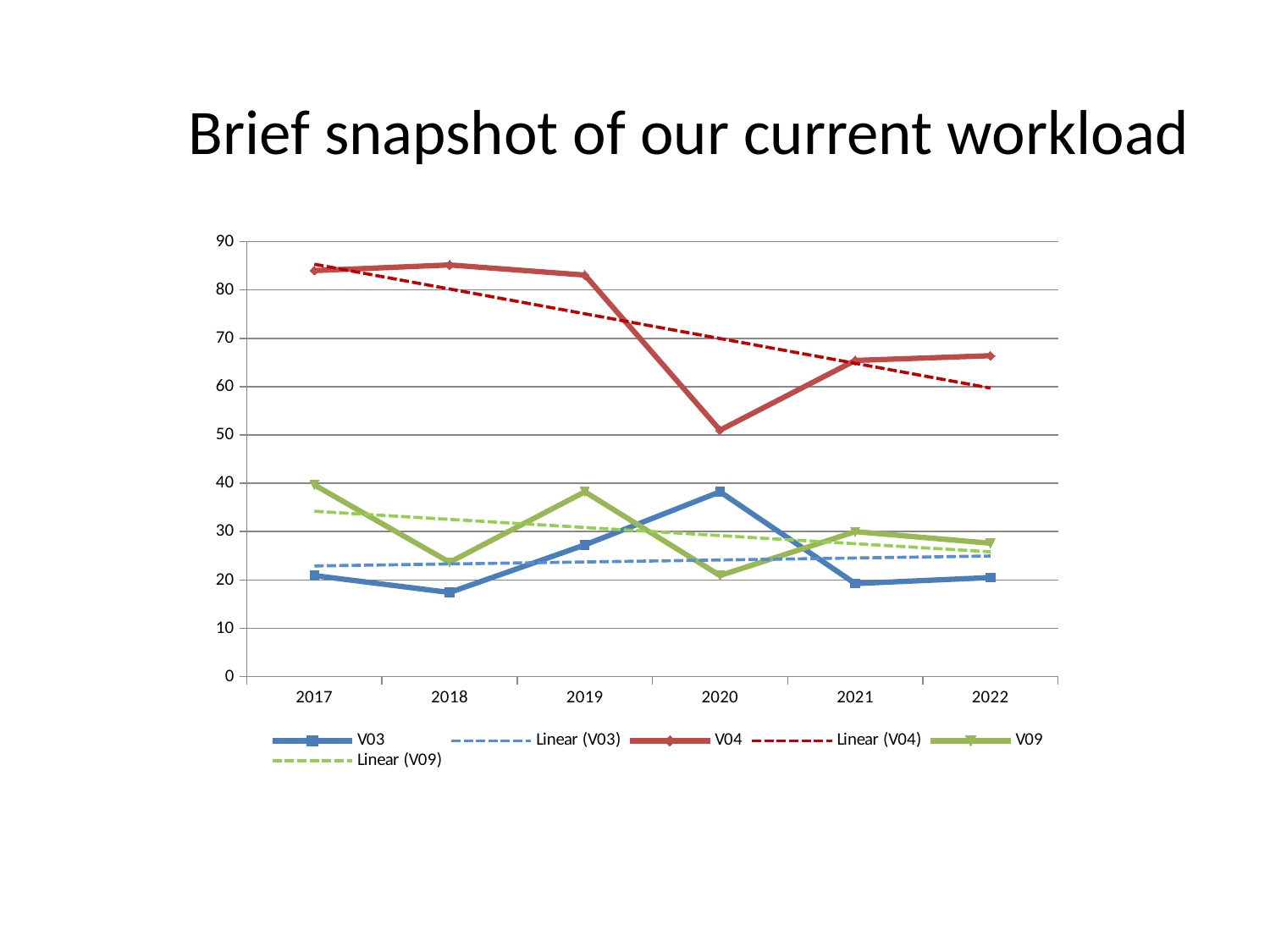
How many years are shown on the x axis of the chart? 6 In which year does the V04 series reach its lowest value? 2020 Which series has the highest values across all years shown? V04 Does the Linear (V04) trendline rise or fall from 2017 to 2022? Fall Is the value for V04 in 2017 greater or less than 80? greater What kind of chart is shown on the slide? Line chart Is the value for V04 in 2020 greater or less than 60? less In which year does the V03 series reach its highest value? 2020 How many entries does the chart's legend list? 6 Which series has the larger value in 2020, V03 or V09? V03 What is the title of the slide containing the chart? Brief snapshot of our current workload Is the value for V03 in 2018 greater or less than 20? less